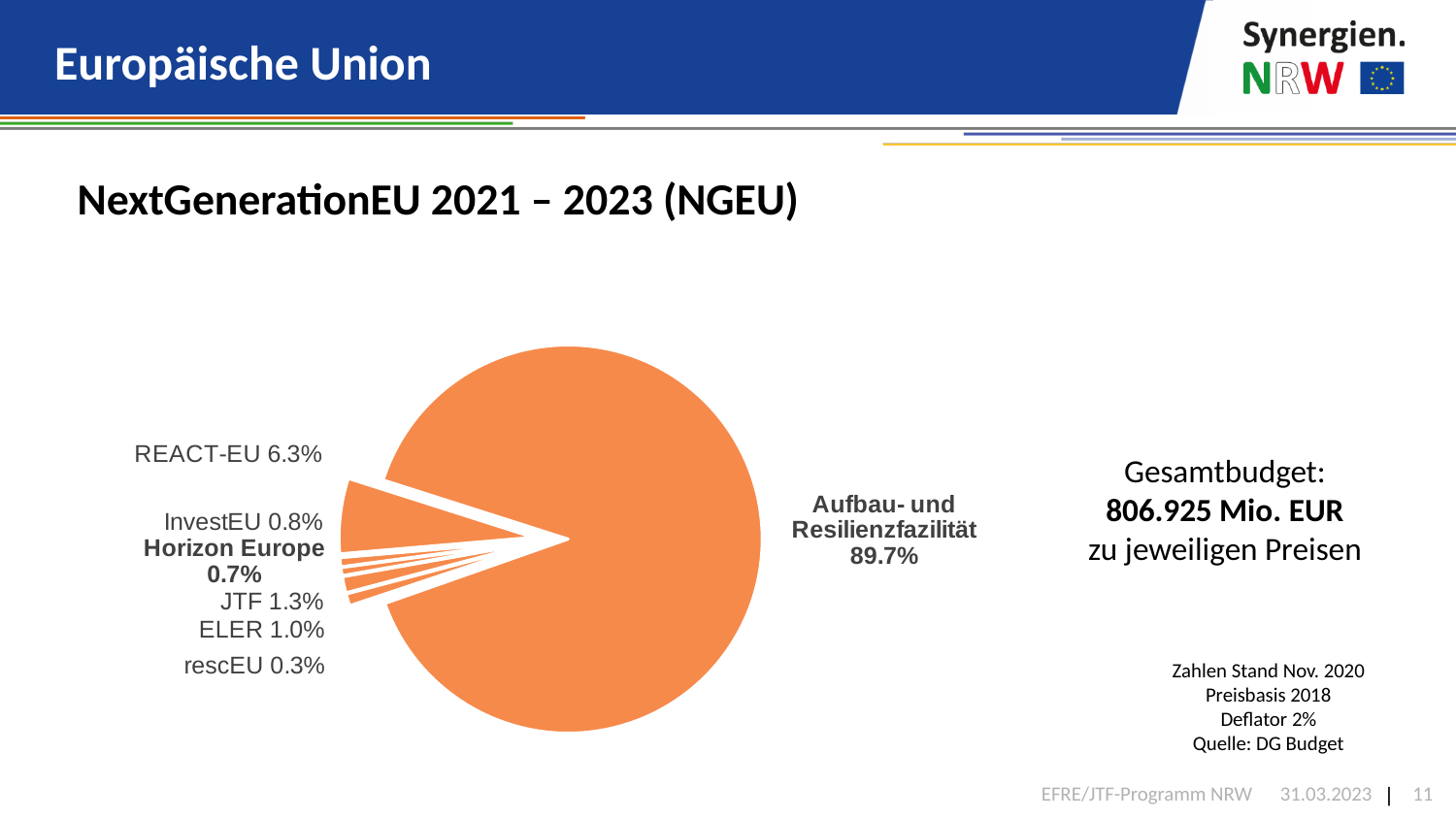
What share of the pie does REACT-EU have? 6.3% What share of the pie does JTF have? 1.3% What share of the pie does Aufbau- und Resilienzfazilität have? 89.7% Which has the larger share, ELER or InvestEU? ELER How many slices does the pie chart have? 7 Which slice of the pie is the largest? Aufbau- und Resilienzfazilität What is the title of the chart on the slide? NextGenerationEU 2021 – 2023 (NGEU) Which slice of the pie is the smallest? rescEU What kind of chart is shown on the slide? pie chart What share of the pie does rescEU have? 0.3% What is the difference in percentage points between REACT-EU and JTF? 5.0 percentage points What share of the pie does Horizon Europe have? 0.7%